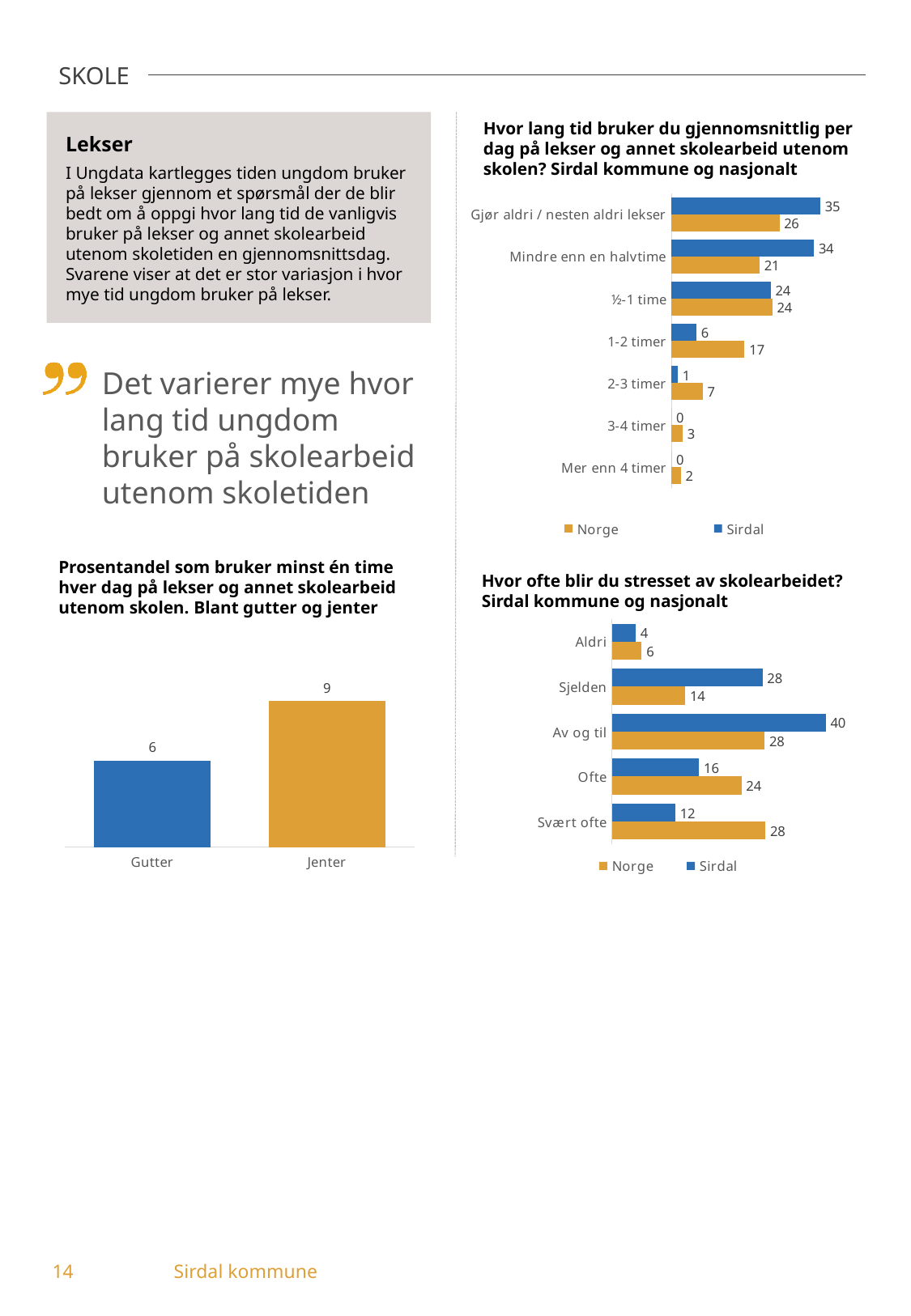
In the chart 'Hvor lang tid bruker du gjennomsnittlig per dag på lekser og annet skolearbeid utenom skolen?', how many categories are shown? 7 In the chart 'Hvor lang tid bruker du gjennomsnittlig per dag på lekser og annet skolearbeid utenom skolen?', what is the value for Norge in the category '1-2 timer'? 17 In the chart 'Hvor ofte blir du stresset av skolearbeidet?', what is the value for Sirdal in the category 'Av og til'? 40 In the chart 'Hvor lang tid bruker du gjennomsnittlig per dag på lekser og annet skolearbeid utenom skolen?', what is the difference between Sirdal and Norge for 'Mindre enn en halvtime'? 13 In the chart 'Hvor ofte blir du stresset av skolearbeidet?', what is the difference between Norge and Sirdal for 'Svært ofte'? 16 In the chart 'Prosentandel som bruker minst én time hver dag på lekser og annet skolearbeid utenom skolen', which is larger, Gutter or Jenter? Jenter In the chart 'Hvor ofte blir du stresset av skolearbeidet?', which category has the lowest value for Norge? Aldri In the chart 'Hvor lang tid bruker du gjennomsnittlig per dag på lekser og annet skolearbeid utenom skolen?', what is the value for Sirdal in the category 'Gjør aldri / nesten aldri lekser'? 35 In the chart 'Hvor lang tid bruker du gjennomsnittlig per dag på lekser og annet skolearbeid utenom skolen?', which category has the highest value for Norge? Gjør aldri / nesten aldri lekser In the chart 'Prosentandel som bruker minst én time hver dag på lekser og annet skolearbeid utenom skolen', what is the value for Jenter? 9 What kind of chart is 'Prosentandel som bruker minst én time hver dag på lekser og annet skolearbeid utenom skolen'? Bar chart How many series does the legend list in the chart 'Hvor ofte blir du stresset av skolearbeidet?'? 2